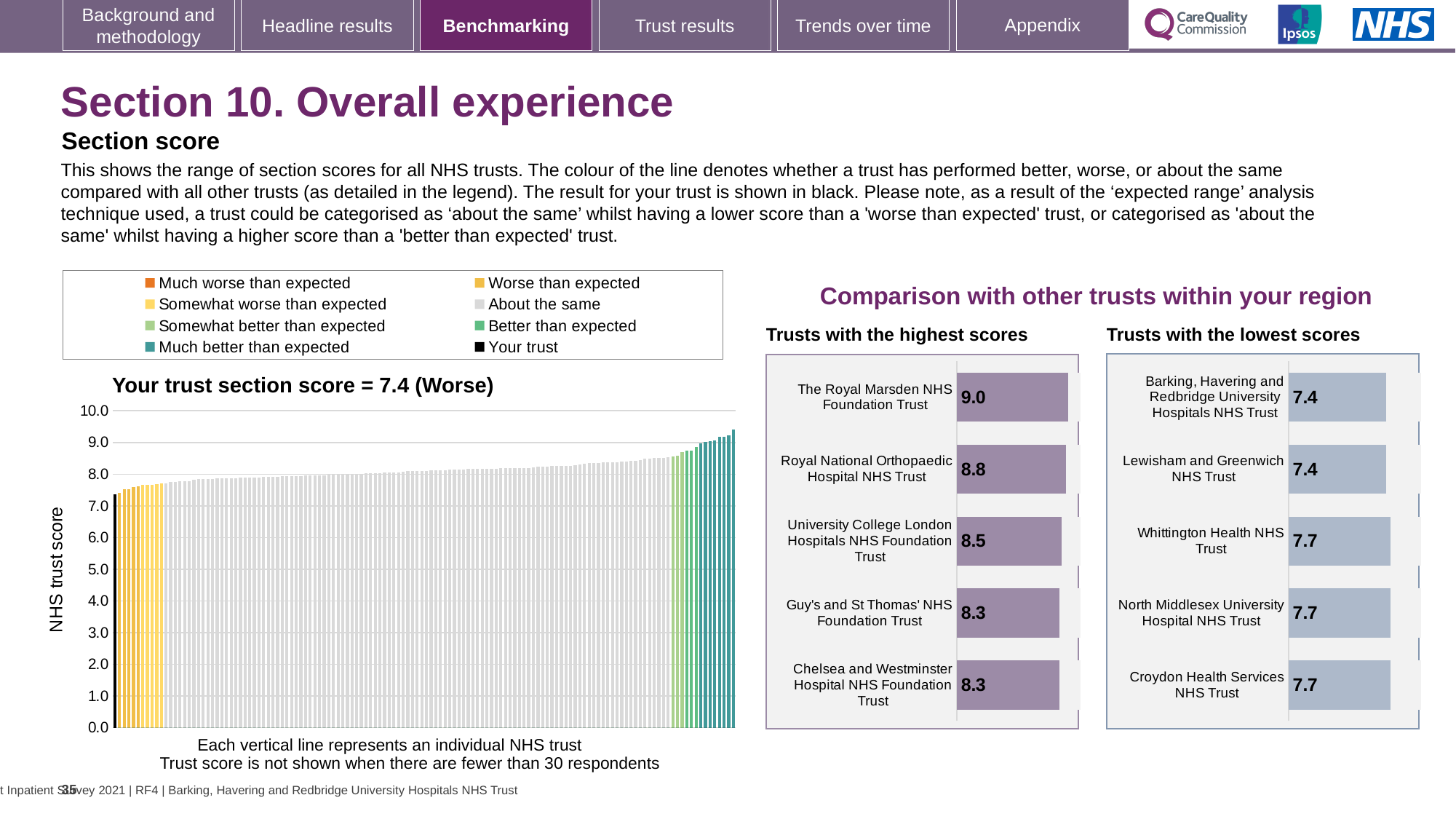
In the 'Trusts with the highest scores' chart, what is the score for The Royal Marsden NHS Foundation Trust? 9.0 In the 'Trusts with the highest scores' chart, which trust has the highest score? The Royal Marsden NHS Foundation Trust How many trusts are shown in the 'Trusts with the lowest scores' chart? 5 How many entries does the legend above the 'Your trust section score' chart list? 8 What is the label on the vertical axis of the 'Your trust section score' chart? NHS trust score In the 'Your trust section score' chart, is the highest trust score greater or less than 9.0? greater In the 'Trusts with the lowest scores' chart, what is the score for Croydon Health Services NHS Trust? 7.7 In the 'Your trust section score' chart, do the trust scores rise or fall from left to right? rise What kind of chart is the 'Your trust section score' chart? bar chart In the chart titled 'Your trust section score', what is the section score for your trust? 7.4 In the 'Trusts with the lowest scores' chart, which has the larger score: Whittington Health NHS Trust or Lewisham and Greenwich NHS Trust? Whittington Health NHS Trust In the 'Trusts with the highest scores' chart, what is the difference between the scores of The Royal Marsden NHS Foundation Trust and Royal National Orthopaedic Hospital NHS Trust? 0.2